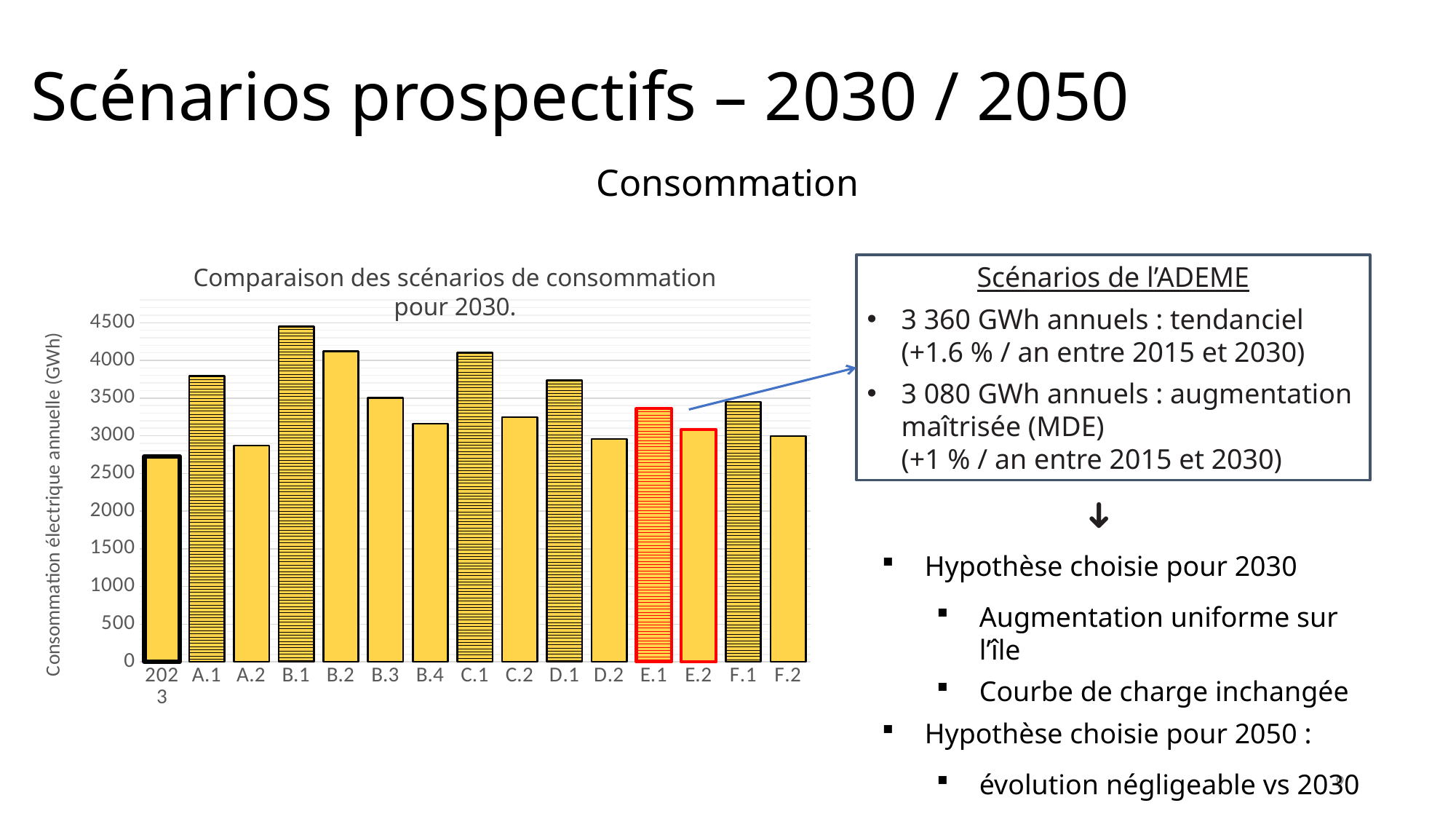
Is the value for 2023 greater or less than 3000? less Which is larger, the value for C.1 or the value for C.2? C.1 What is the title of the chart? Comparaison des scénarios de consommation pour 2030. What is the label of the vertical axis of the chart? Consommation électrique annuelle (GWh) Which category has the lowest value in the chart? 2023 Is the value for B.1 greater or less than 4000? greater What kind of chart is shown on the slide? Bar chart Is the value for A.2 greater or less than 3000? less Which is larger, the value for E.1 or the value for E.2? E.1 Which scenario has the highest annual electricity consumption in the chart? B.1 How many categories (bars) are shown on the x axis of the chart? 15